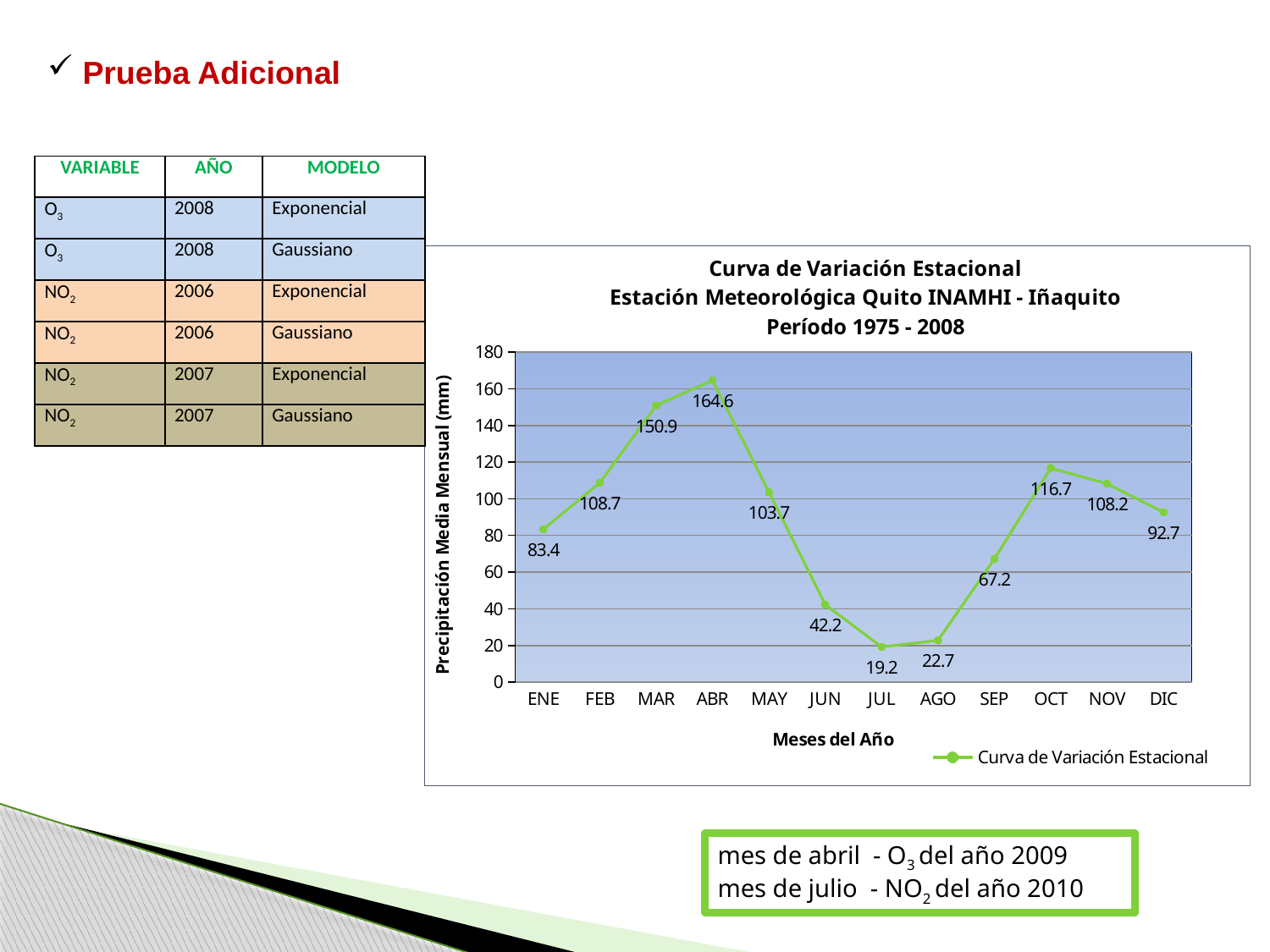
What kind of chart is shown on the slide? line chart Which month has the highest precipitation value in the chart? ABR Which month has a larger precipitation value, OCT or NOV? OCT What is the difference between the precipitation values for ABR and JUL? 145.4 Which month has the lowest precipitation value in the chart? JUL What is the precipitation value for JUL (July) in the chart? 19.2 What is the precipitation value for ABR (April) in the chart? 164.6 What is the precipitation value for ENE (January) in the chart? 83.4 Do the values rise or fall from ABR to JUL? fall Is the value for MAY greater or less than 100? greater How many months are plotted on the x axis of the chart? 12 How many series does the chart legend list? 1